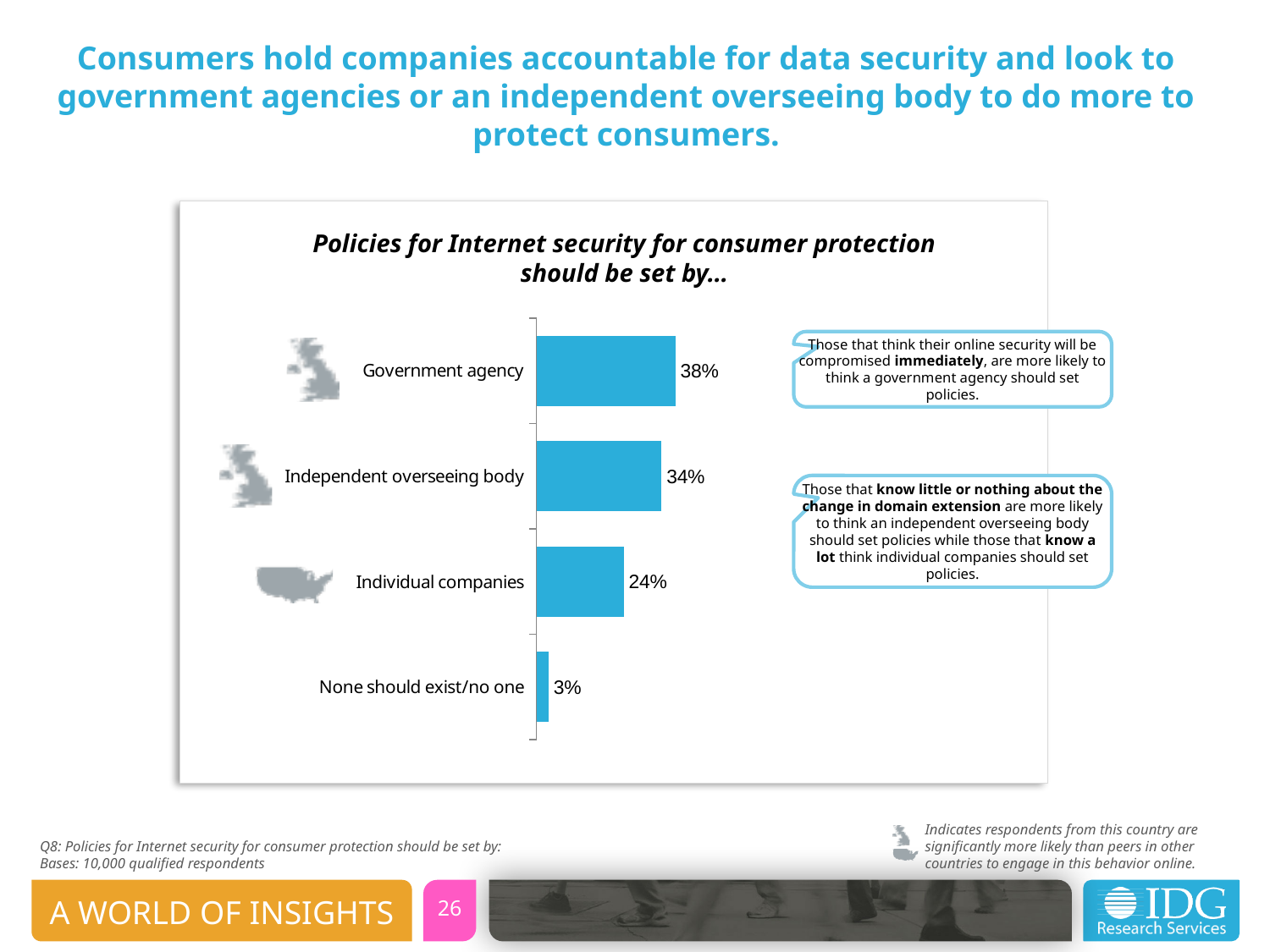
What percentage of respondents think policies should be set by a government agency? 38% What is the value for 'Independent overseeing body'? 34% Which category has the lowest value? None should exist/no one What kind of chart is shown on the slide? Bar chart Which category has the highest value? Government agency Which is larger, the value for 'Individual companies' or 'None should exist/no one'? Individual companies What is the value for 'Individual companies'? 24% How many categories are shown in the chart? 4 What is the title of the chart? Policies for Internet security for consumer protection should be set by… What is the value for 'None should exist/no one'? 3% What is the difference between the values for 'Government agency' and 'Independent overseeing body'? 4% What is the difference between the values for 'Independent overseeing body' and 'Individual companies'? 10%